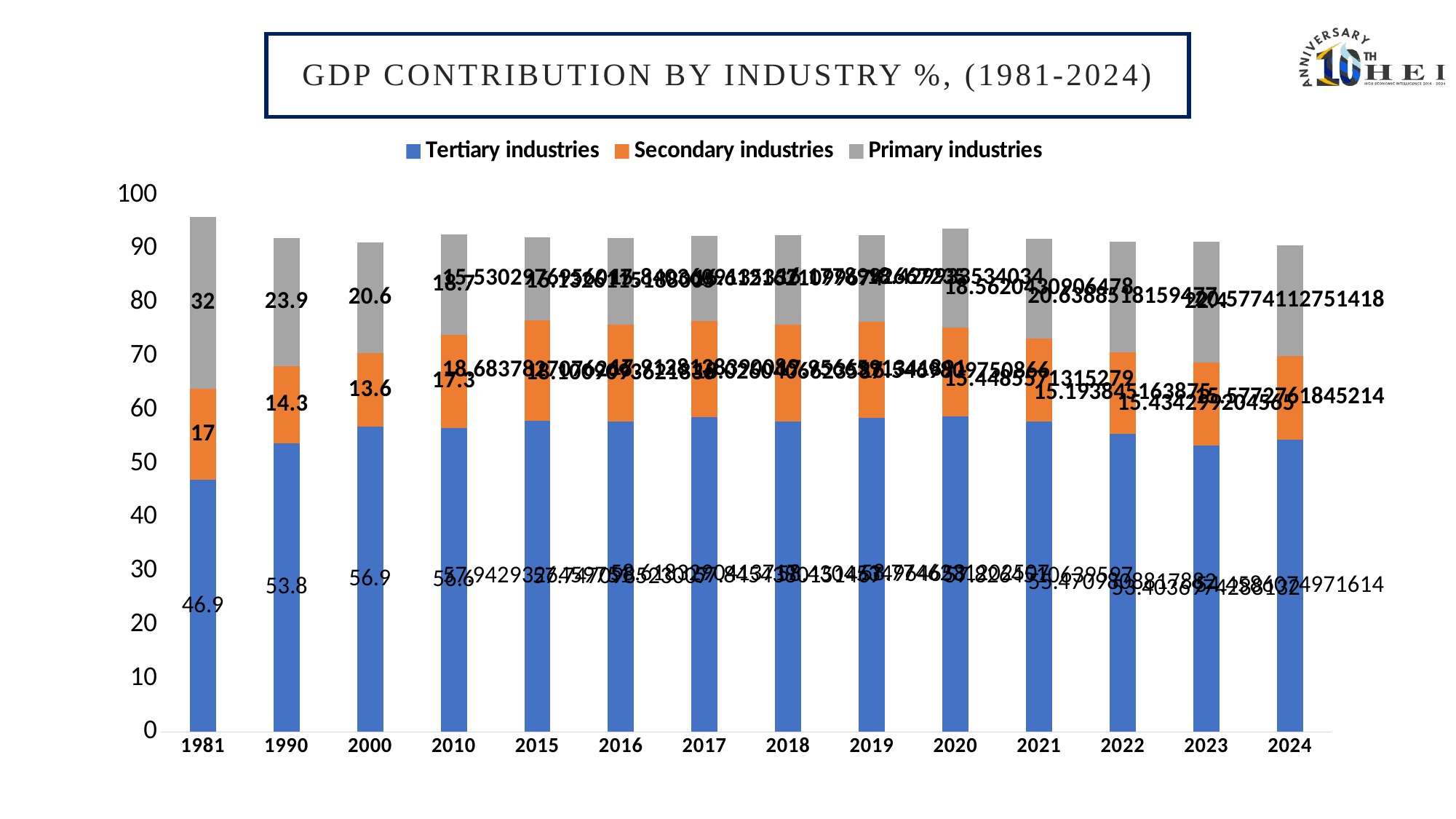
Is the value for Tertiary industries in 2020 greater or less than 50? greater What is the value for Tertiary industries in 1981? 46.9 What is the difference between the Tertiary industries values for 2000 and 1981? 10 Which series is shown in orange in the legend? Secondary industries What is the value for Secondary industries in 1990? 14.3 How many series does the legend list? 3 What is the value for Primary industries in 2000? 20.6 What is the total of the stacked bar for 1981? 95.9 How many years are shown on the x axis? 14 What type of chart is shown on the slide? stacked bar chart Which is larger, the Primary industries value in 1981 or in 1990? 1981 What is the value for Primary industries in 1981? 32